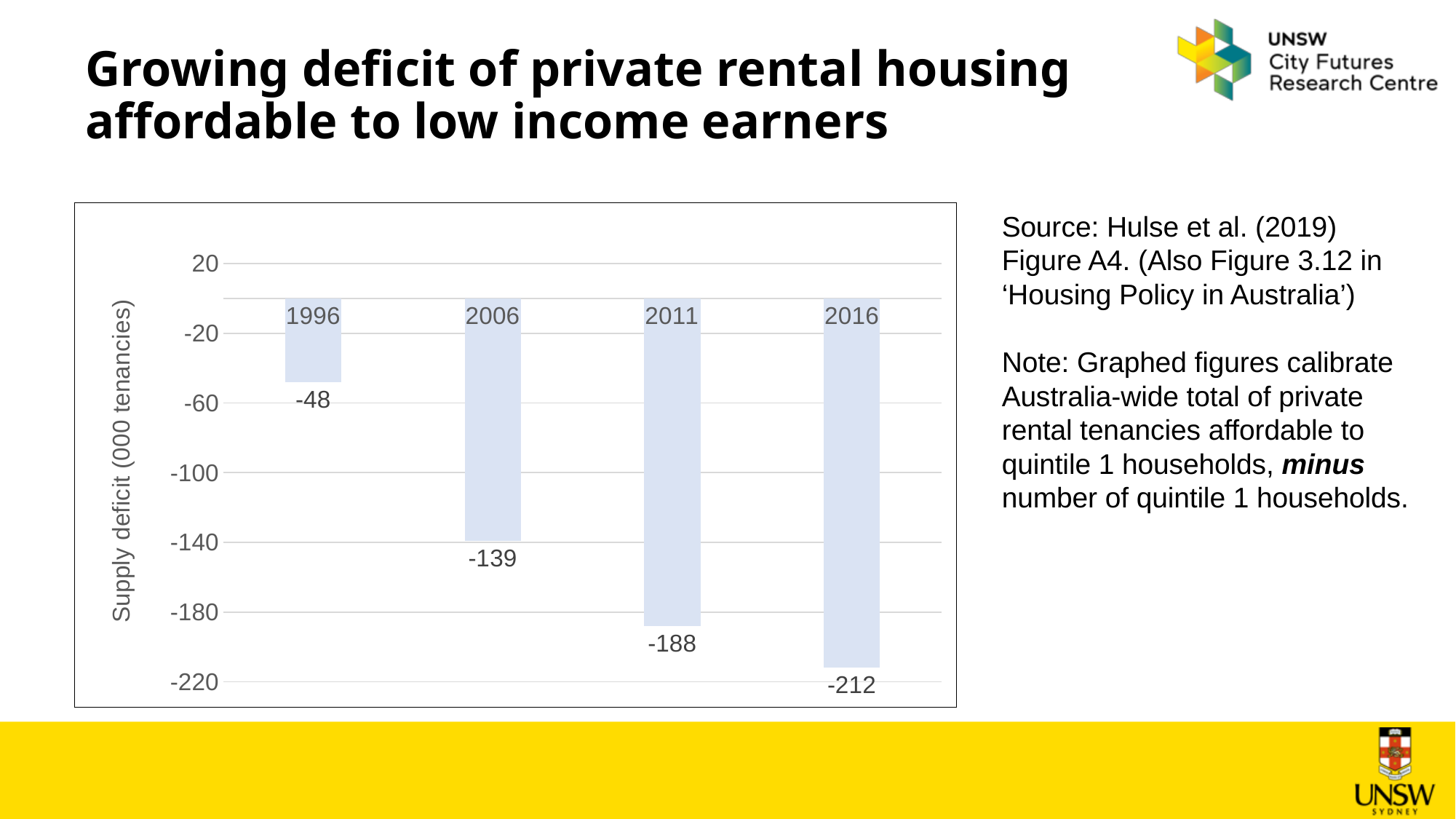
What is the difference between the 2011 value and the 2006 value? 49 What is the supply deficit value shown for 2011? -188 What is the supply deficit value shown for 1996? -48 What type of chart is shown on the slide? Bar chart Which year has the highest (least negative) supply deficit value? 1996 What is the supply deficit value shown for 2006? -139 What is the difference between the 2016 value and the 1996 value? 164 What is the supply deficit value shown for 2016? -212 What is the label of the vertical axis of the chart? Supply deficit (000 tenancies) Which year has the lowest (most negative) supply deficit value? 2016 How many years are plotted in the chart? 4 Which year has a larger supply deficit (more negative value), 2006 or 2011? 2011